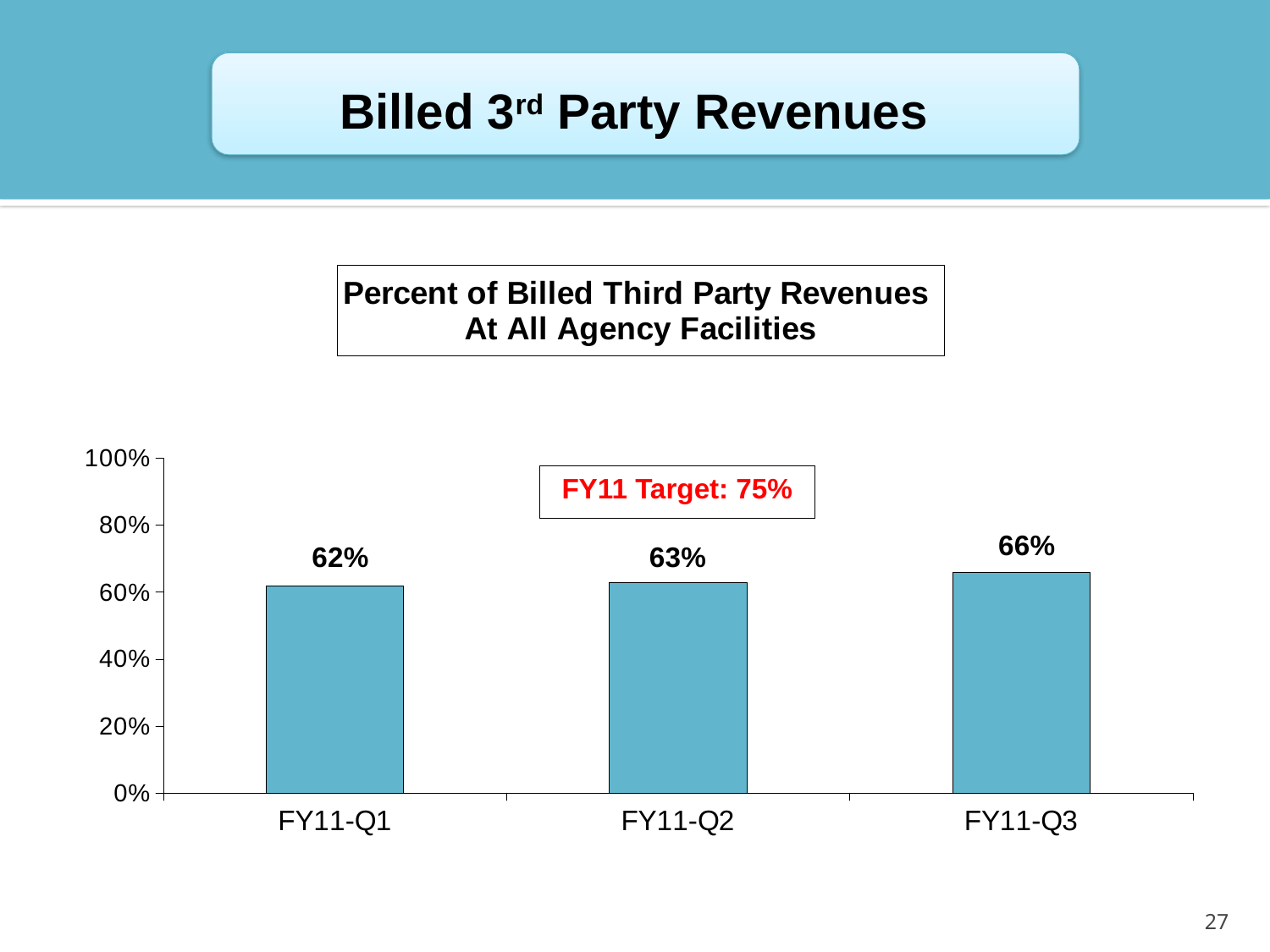
Which is larger, the value for FY11-Q3 or FY11-Q2? FY11-Q3 Which quarter has the lowest value? FY11-Q1 What is the difference between the values for FY11-Q3 and FY11-Q1? 4% Is the value for FY11-Q3 greater or less than 80%? less Do the values rise or fall from FY11-Q1 to FY11-Q3? rise What kind of chart is shown on the slide? bar chart What is the value for FY11-Q3? 66% What is the value for FY11-Q1? 62% What is the difference between the values for FY11-Q2 and FY11-Q1? 1% Which quarter has the highest value? FY11-Q3 How many quarters are shown on the chart? 3 What is the value for FY11-Q2? 63%